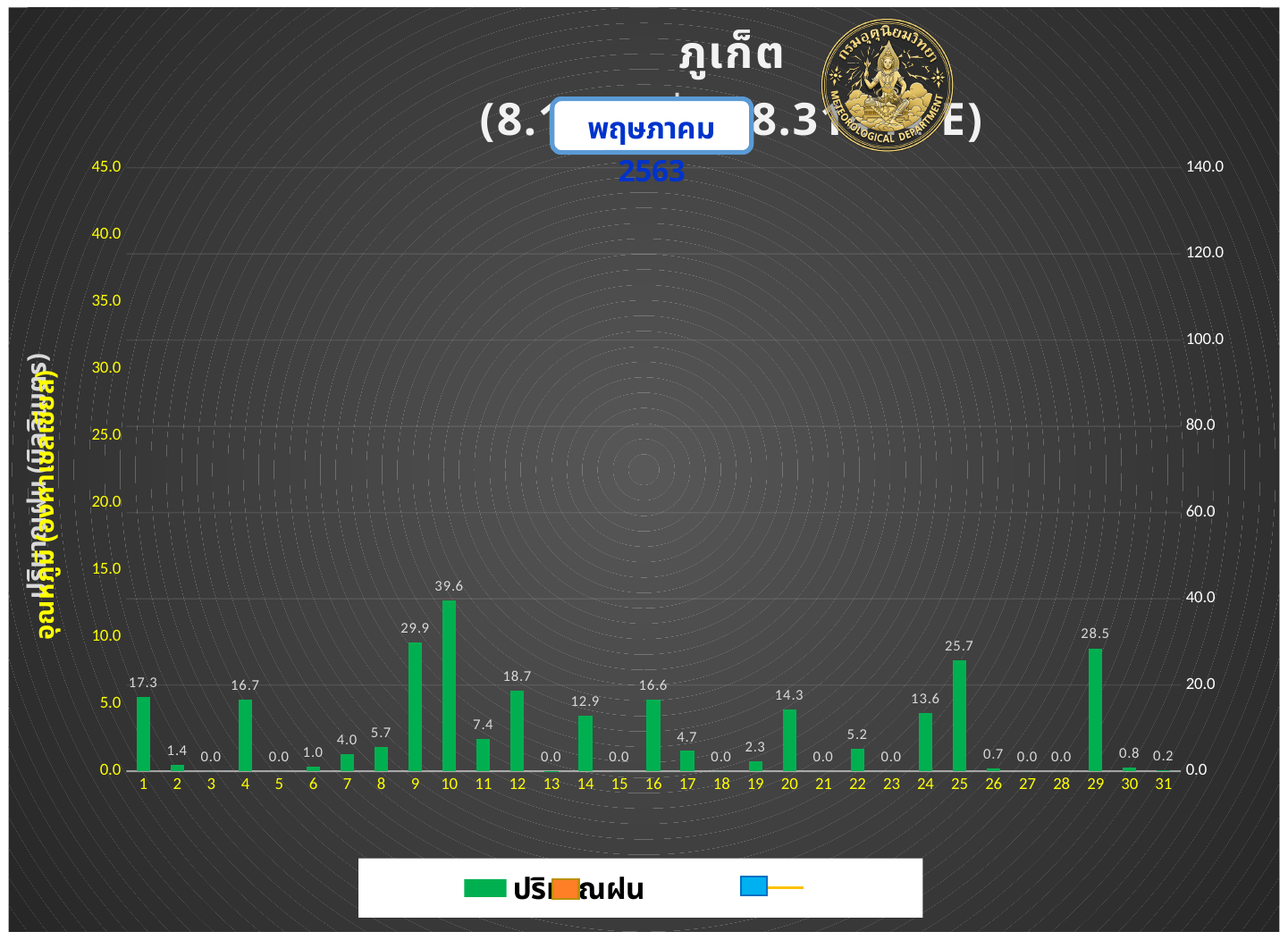
How many days are shown on the x axis? 31 What kind of chart is this? bar chart What is the difference between the values for day 10 and day 9? 9.7 What year is shown below the month label on the chart? 2563 What is the difference between the values for day 29 and day 25? 2.8 What is the value shown for day 10? 39.6 What is the value shown for day 25? 25.7 Which day has the highest value? 10 Which is larger, the value for day 12 or the value for day 16? day 12 What is the value shown for day 14? 12.9 What is the value shown for day 1? 17.3 Which is larger, the value for day 20 or the value for day 24? day 20